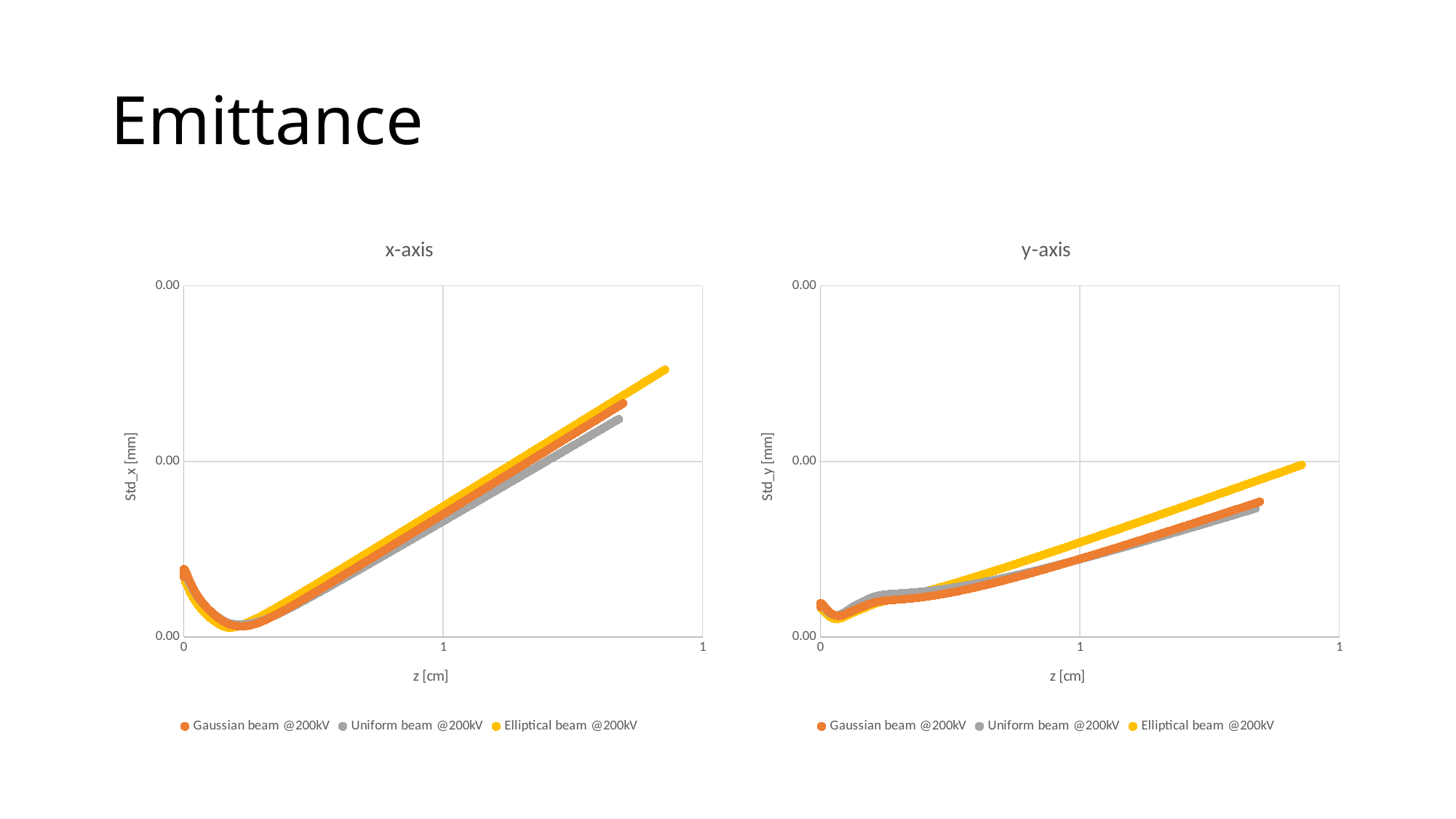
In the x-axis chart, which series reaches the highest Std_x value at the right end of the plot? Elliptical beam @200kV How many series does the legend of the x-axis chart list? 3 In the x-axis chart, at the right end of the plot, is the Elliptical beam @200kV value larger or smaller than the Uniform beam @200kV value? larger In the x-axis chart, after the initial dip near z = 0, do the Std_x values rise or fall as z increases? rise How many series does the legend of the y-axis chart list? 3 What kind of chart is the x-axis chart? scatter chart In the x-axis chart, which series ends with the lowest Std_x value at the right end of the plot? Uniform beam @200kV What is the label of the vertical axis of the y-axis chart? Std_y [mm] In the y-axis chart, at the right end of the plot, is the Elliptical beam @200kV value larger or smaller than the Gaussian beam @200kV value? larger In the y-axis chart, which series reaches the highest Std_y value at the right end of the plot? Elliptical beam @200kV In the y-axis chart, do the Std_y values generally rise or fall as z increases? rise What is the label of the horizontal axis of the x-axis chart? z [cm]